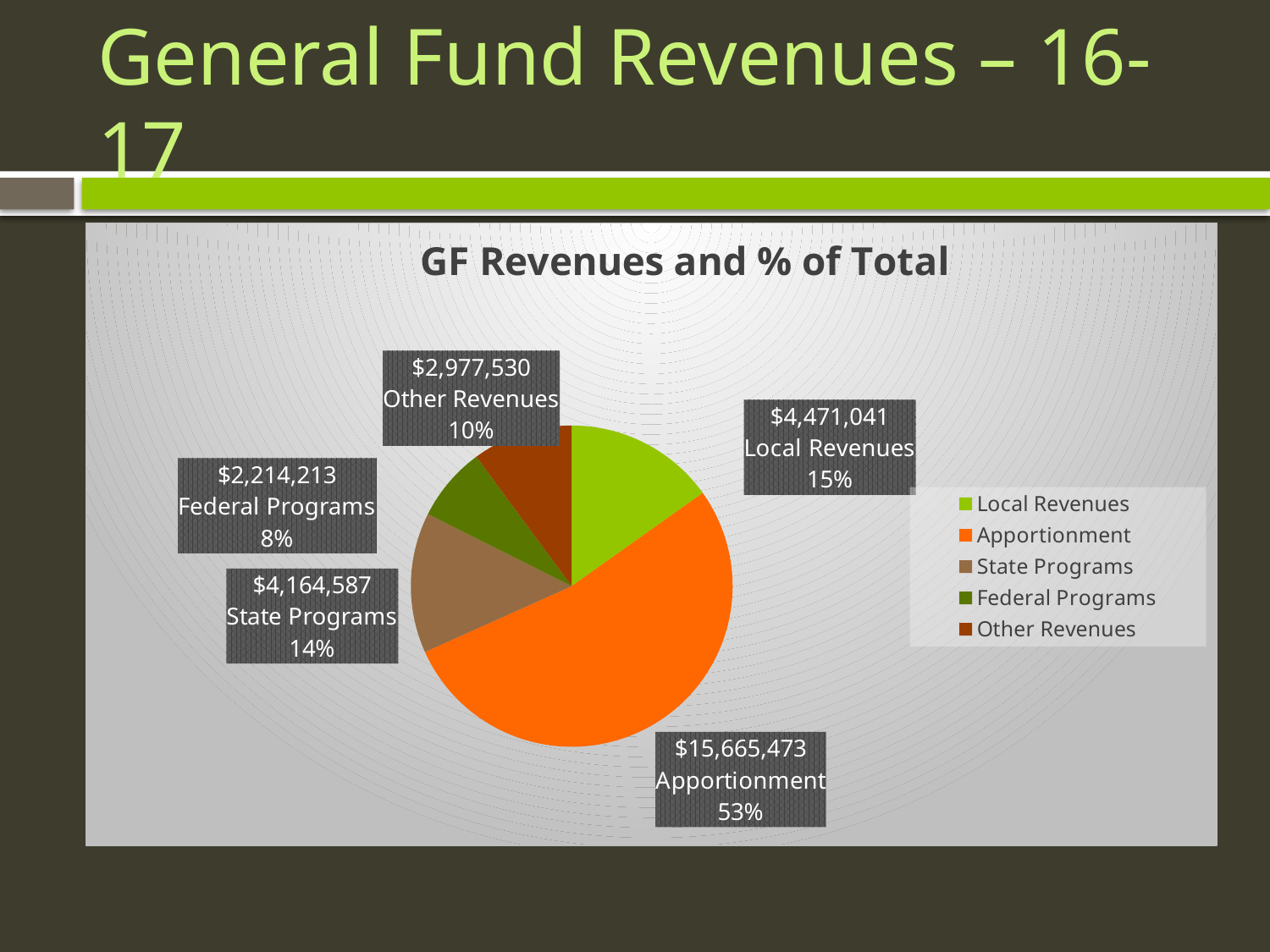
Which category has the largest slice? Apportionment What is the value for Local Revenues? $4,471,041 How many categories are shown in the pie chart? 5 What is the title of the chart? GF Revenues and % of Total What is the value for Federal Programs? $2,214,213 What is the value for Apportionment? $15,665,473 Which is larger, Other Revenues or Federal Programs? Other Revenues Which category has the smallest slice? Federal Programs What is the difference between Local Revenues and State Programs? $306,454 What percentage of the total is State Programs? 14% What share of the pie does Other Revenues represent? 10% What type of chart is shown? Pie chart